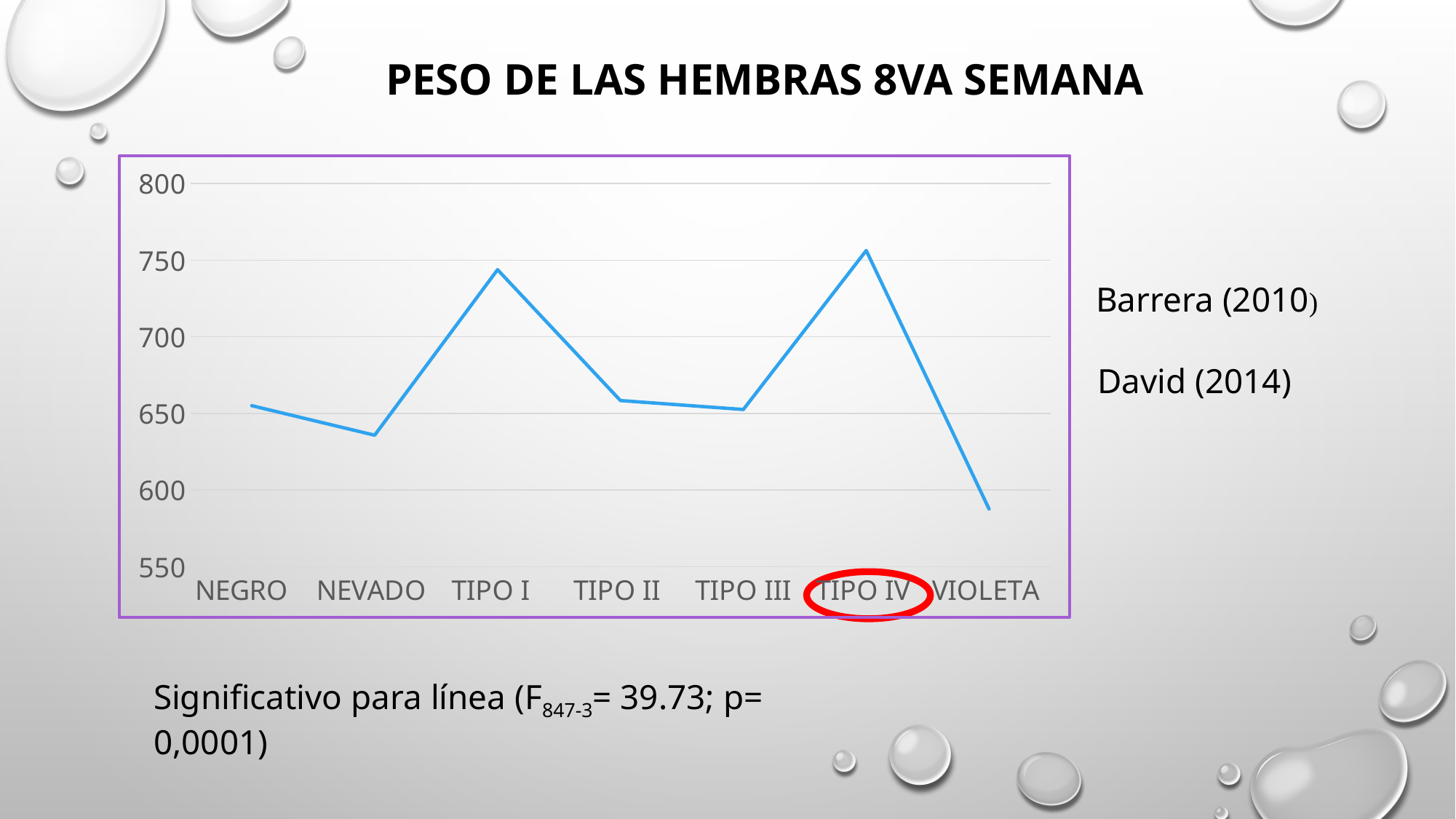
Is the value for TIPO I greater or less than 700? greater How many categories are plotted along the x axis? 7 Which is larger, the value for NEGRO or the value for NEVADO? NEGRO Is the value for NEVADO greater or less than 650? less Does the line rise or fall from TIPO IV to VIOLETA? fall Which category has the lowest value? VIOLETA Which is larger, the value for TIPO I or the value for TIPO II? TIPO I Which category has the highest value? TIPO IV What kind of chart is shown on the slide? line chart Is the value for TIPO II greater or less than 700? less Which category label on the x axis is circled in red? TIPO IV